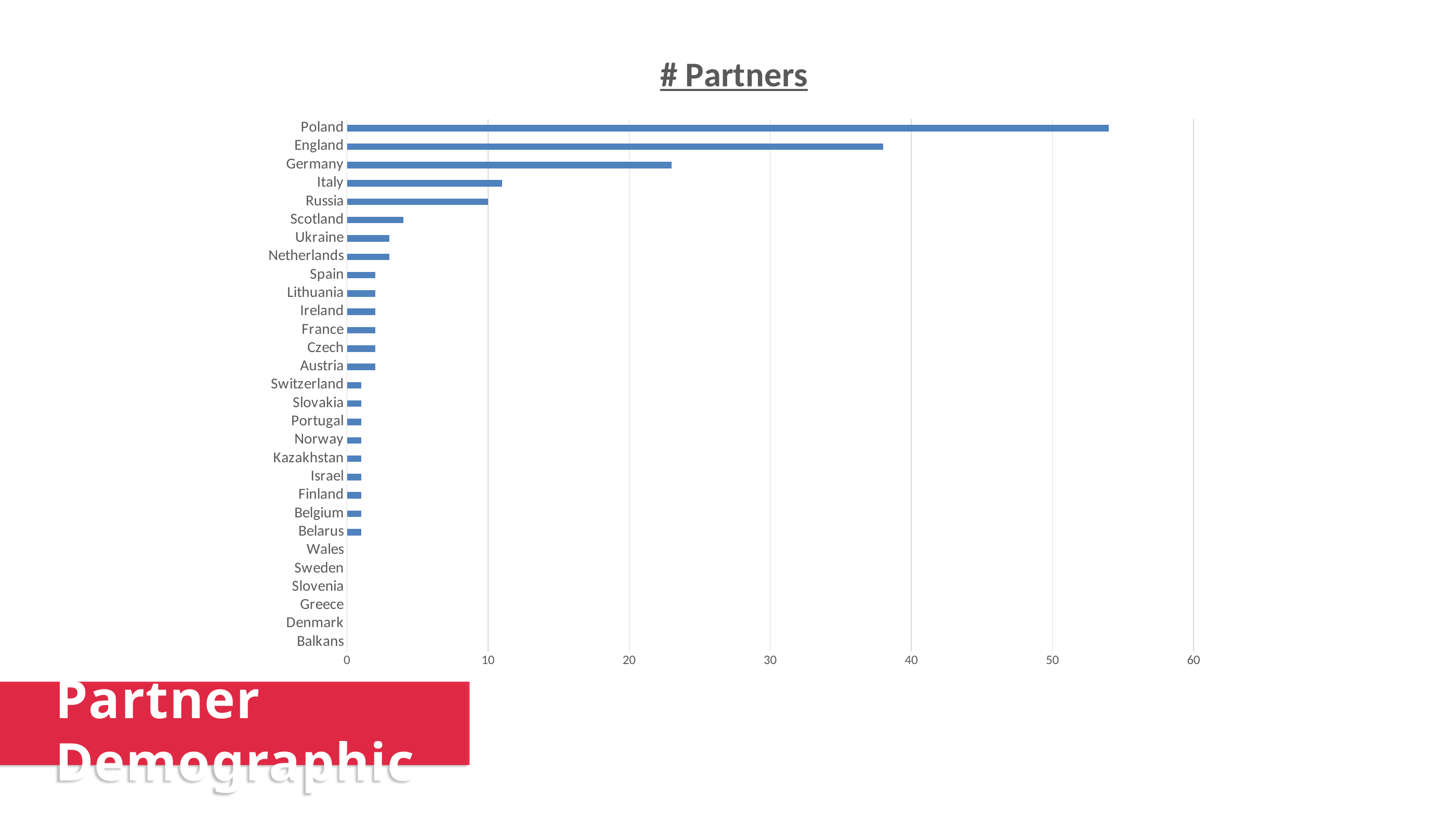
Is the value for Scotland greater or less than 10? less Is the value for England greater or less than 40? less What is the title of the chart? # Partners Which has more partners, Scotland or Italy? Italy Is the value for Italy greater or less than 10? greater What kind of chart is shown on the slide? bar chart Which country has the highest number of partners? Poland What is the highest value shown on the horizontal axis? 60 How many countries/regions are listed on the chart? 29 Which has more partners, England or Germany? England